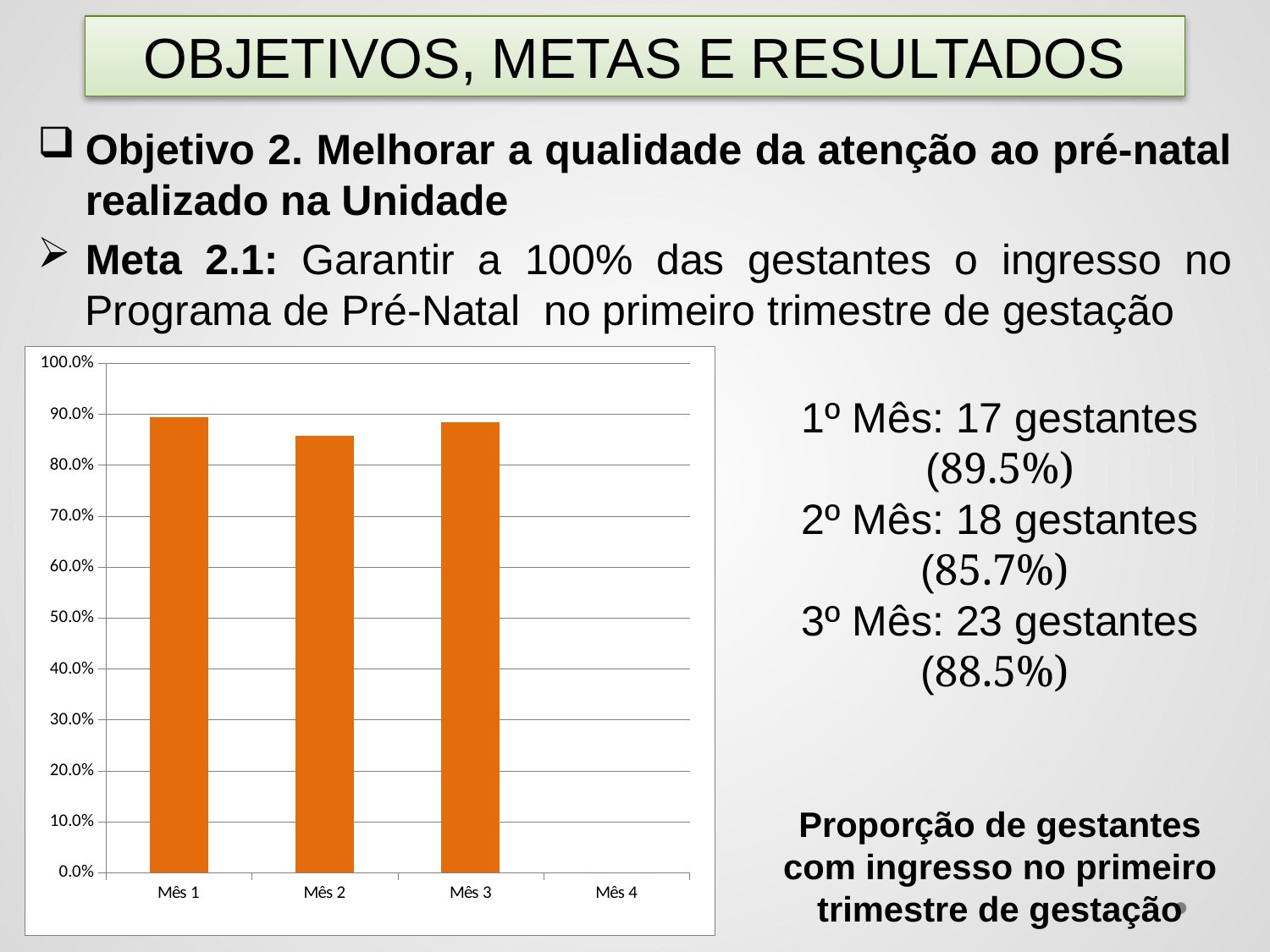
What type of chart is shown on the slide? bar chart What is the proportion for Mês 3? 88.5% What is the highest value shown on the chart's vertical axis? 100.0% How many month categories are labelled on the x axis of the chart? 4 Which is larger, the value for Mês 2 or the value for Mês 3? Mês 3 How many bars are plotted in the chart? 3 What is the difference in percentage points between the values for Mês 1 and Mês 2? 3.8 What is the proportion of pregnant women entering in the first trimester for Mês 1? 89.5% What is the proportion for Mês 2? 85.7% Is the value for Mês 2 greater or less than 80.0%? greater Which is larger, the value for Mês 1 or the value for Mês 2? Mês 1 Which month has the highest proportion in the chart? Mês 1